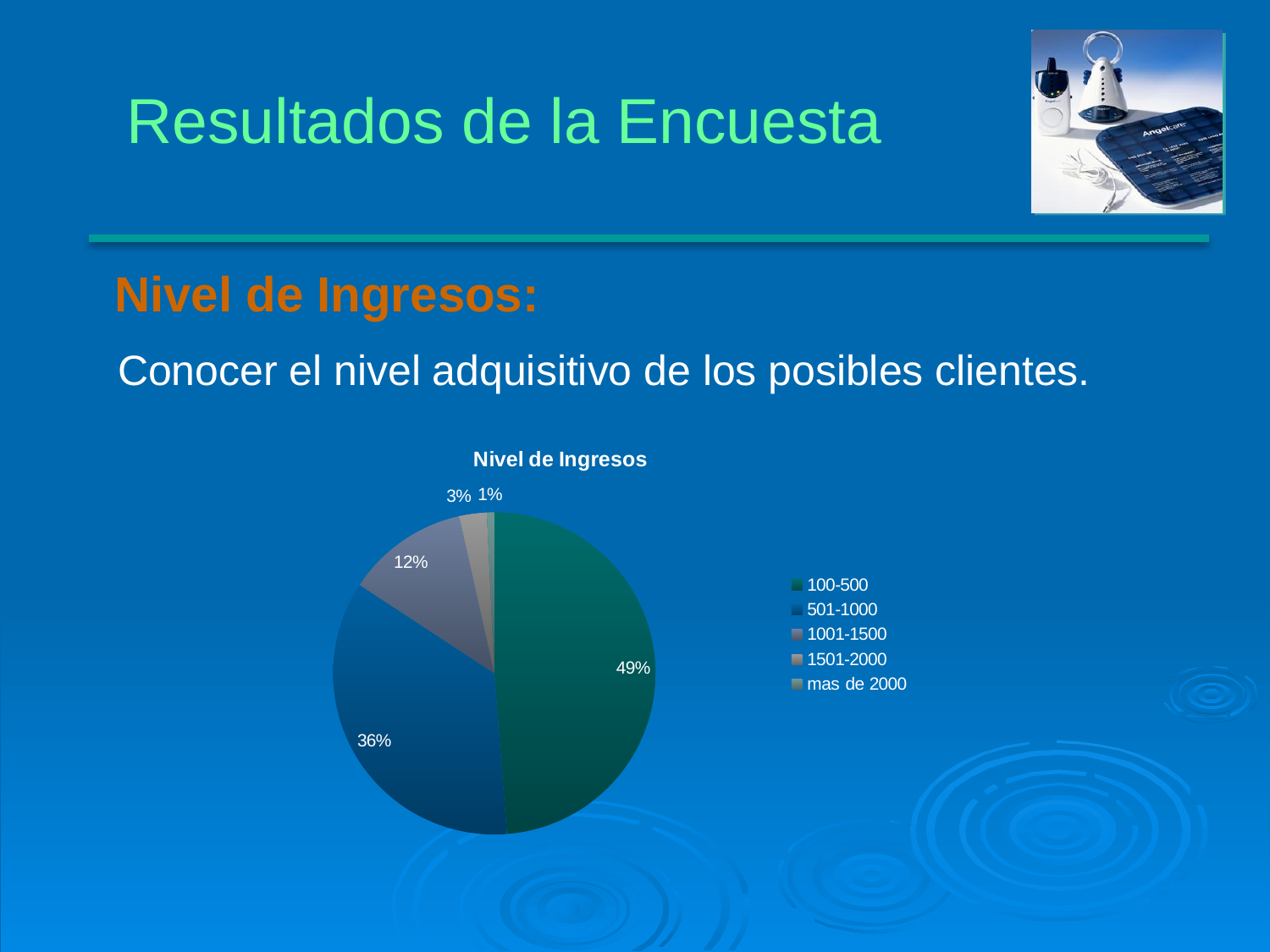
What percentage of the pie does the 'mas de 2000' slice represent? 1% What is the title of the chart? Nivel de Ingresos What percentage of the pie does the 1001-1500 slice represent? 12% How many categories does the legend list? 5 What percentage of the pie does the 1501-2000 slice represent? 3% Which slice is larger, 1001-1500 or 1501-2000? 1001-1500 What percentage of the pie does the 501-1000 slice represent? 36% What percentage of the pie does the 100-500 slice represent? 49% Which income category has the smallest share of the pie? mas de 2000 Which income category has the largest share of the pie? 100-500 What is the difference in percentage points between the 100-500 slice and the 501-1000 slice? 13 What kind of chart is shown on the slide? pie chart